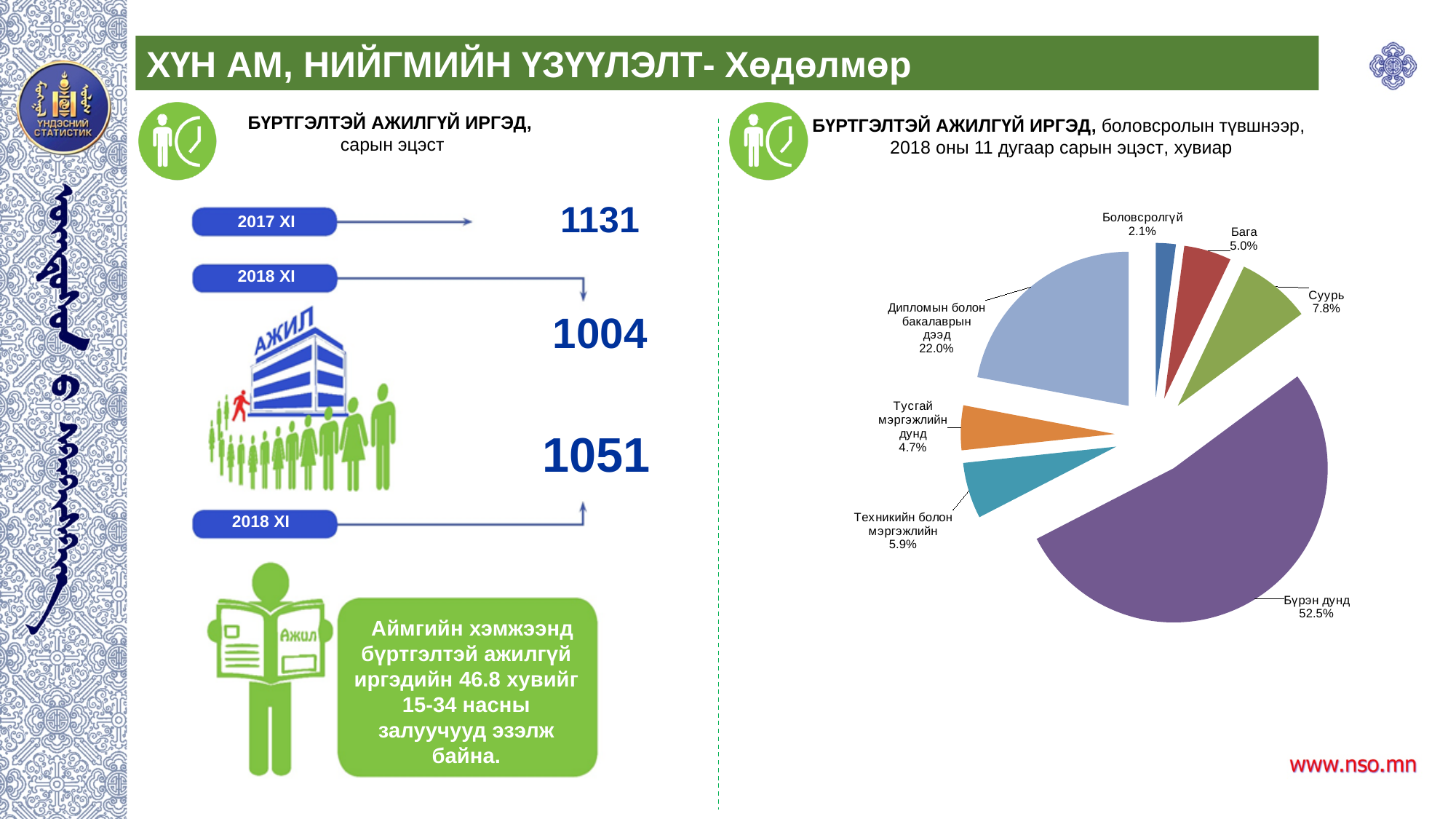
What type of chart is shown on the right side of the slide? Pie chart What is the value shown for "Дипломын болон бакалаврын дээд" in the pie chart? 22.0% What is the difference between the "Суурь" and "Бага" shares in the pie chart? 2.8% What colour is the "Бүрэн дунд" slice in the pie chart? Purple What percentage is shown for "Суурь" in the pie chart? 7.8% How many slices does the pie chart have? 7 Which category has the largest slice in the pie chart? Бүрэн дунд In the pie chart, which is larger: "Бага" or "Тусгай мэргэжлийн дунд"? Бага What is the value for "Техникийн болон мэргэжлийн" in the pie chart? 5.9% Which category has the smallest slice in the pie chart? Боловсролгүй What is the difference between the "Бүрэн дунд" and "Дипломын болон бакалаврын дээд" shares in the pie chart? 30.5% What share of the pie chart does the "Бүрэн дунд" slice represent? 52.5%